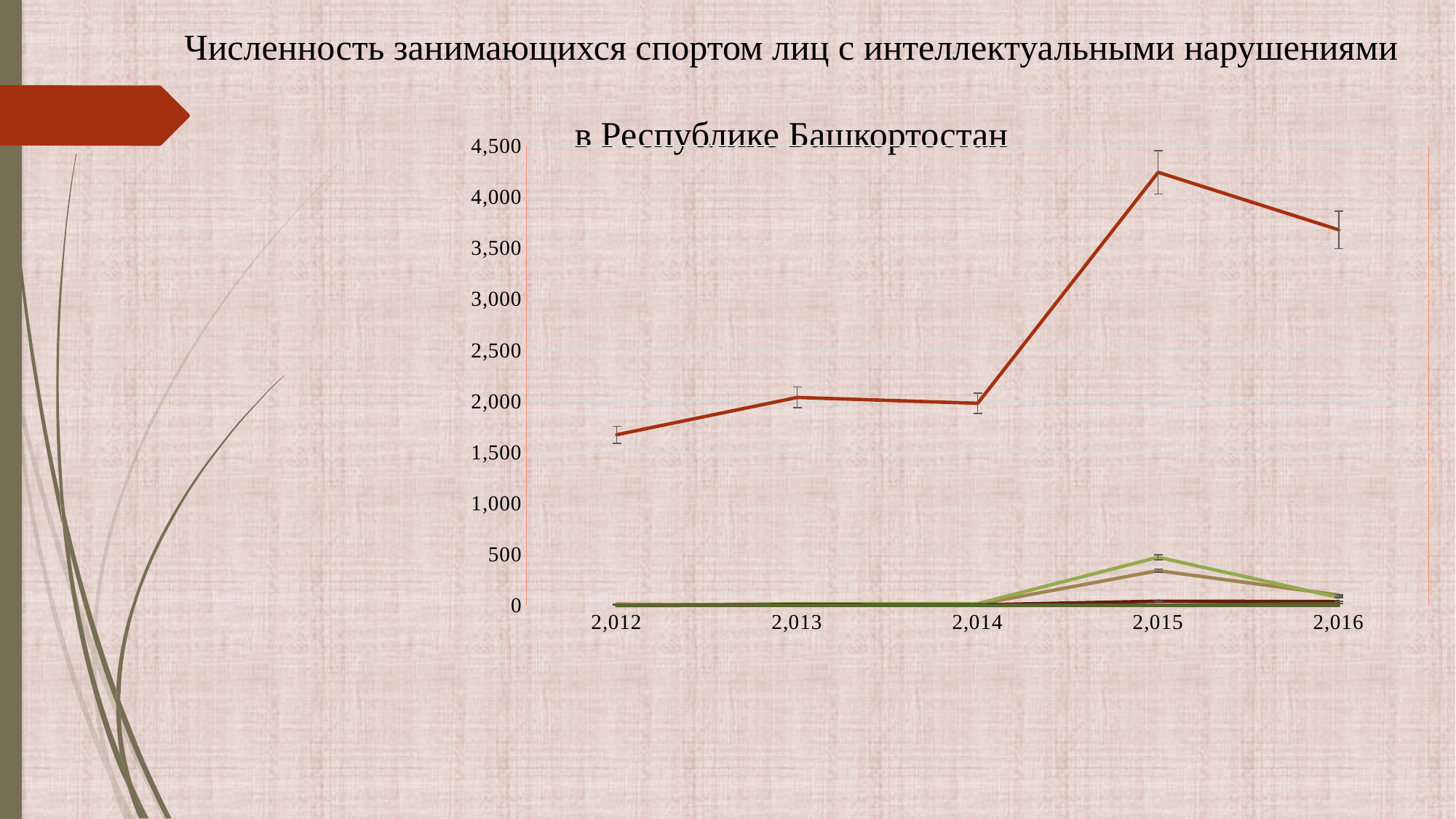
Is the value of the red line for 2,016 greater or less than 3,500? greater Is the value of the red line for 2,012 greater or less than 2,000? less How many years are plotted along the x axis? 5 What kind of chart is shown on the slide? line chart Is the value of the red line for 2,015 greater or less than 4,000? greater Which year has the larger value on the red line, 2,015 or 2,016? 2,015 Does the red line rise or fall between 2,015 and 2,016? fall Does the red line rise or fall between 2,014 and 2,015? rise In which year is the red line at its lowest value? 2,012 What is the highest tick value shown on the y axis? 4,500 In which year does the red line reach its highest value? 2,015